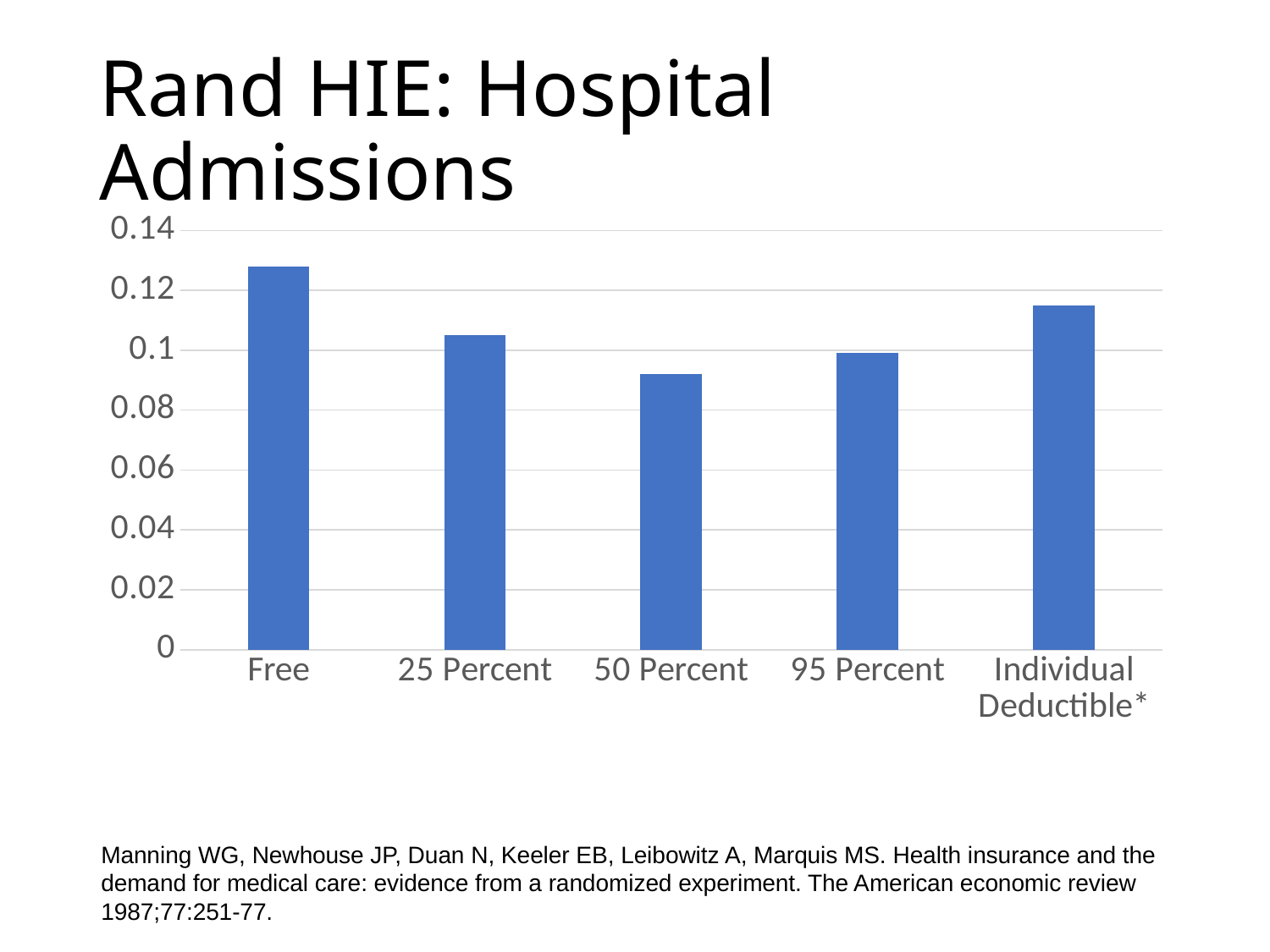
Is the value for 50 Percent greater or less than 0.1? less Is the value for 95 Percent greater or less than 0.08? greater Which category has the lowest hospital admissions value? 50 Percent Which is larger, the value for 25 Percent or the value for 50 Percent? 25 Percent What is the title of the slide containing the chart? Rand HIE: Hospital Admissions Which is larger, the value for Free or the value for Individual Deductible*? Free What type of chart is shown on the slide? bar chart Is the value for Free greater or less than 0.12? greater How many categories are shown on the x axis of the chart? 5 Which category has the highest hospital admissions value? Free